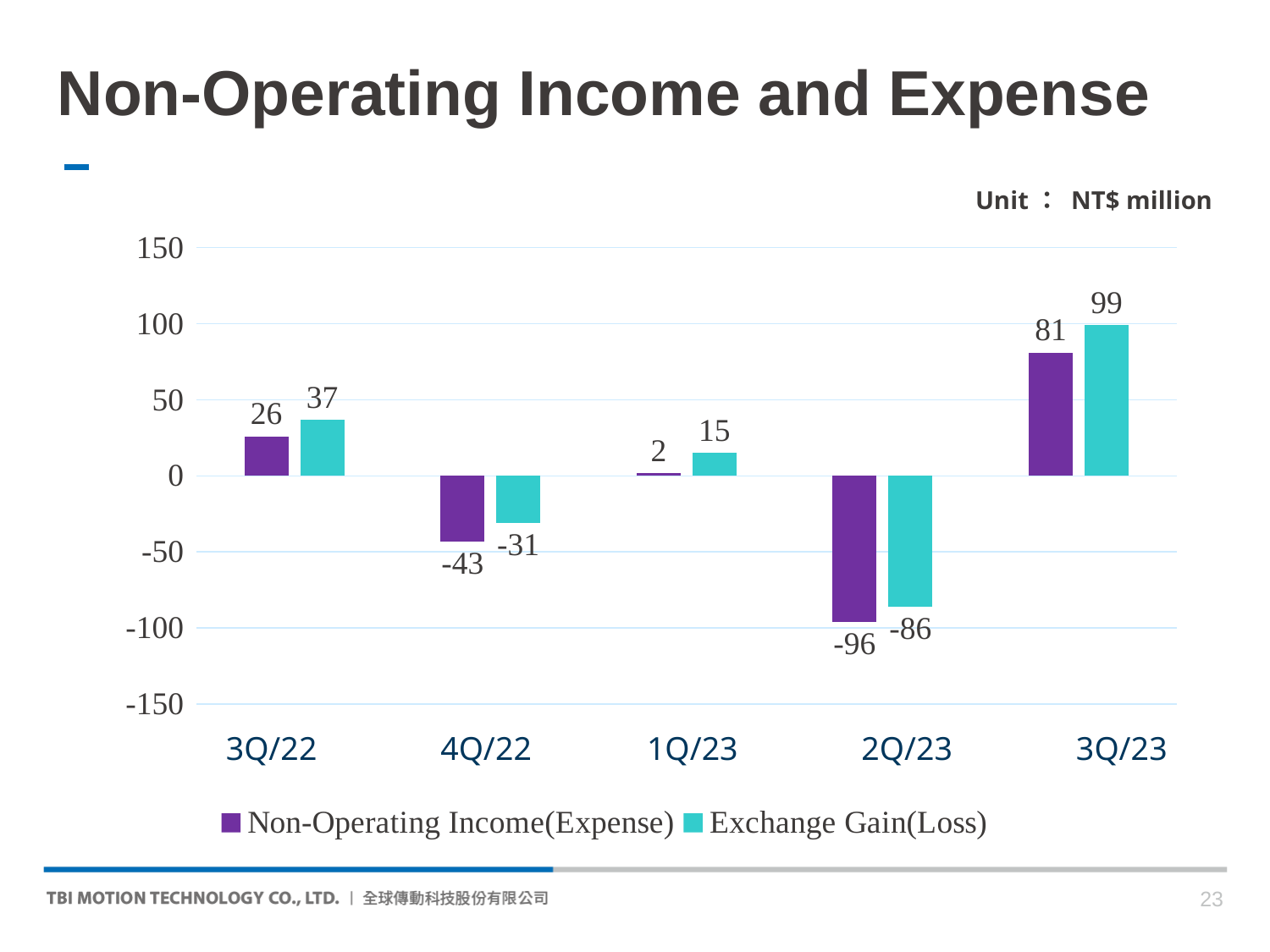
How many quarters are shown on the x axis? 5 Which is larger in 4Q/22: Non-Operating Income(Expense) or Exchange Gain(Loss)? Exchange Gain(Loss) Which colour represents Exchange Gain(Loss) in the legend? Teal What is the Non-Operating Income(Expense) value for 3Q/22? 26 What is the difference between the Exchange Gain(Loss) and Non-Operating Income(Expense) values in 3Q/23? 18 What is the Non-Operating Income(Expense) value for 1Q/23? 2 What kind of chart is shown on the slide? Bar chart What unit is stated for the chart values? NT$ million Which quarter has the highest Exchange Gain(Loss) value? 3Q/23 What is the Exchange Gain(Loss) value for 2Q/23? -86 How many series does the legend list? 2 Which quarter has the lowest Non-Operating Income(Expense) value? 2Q/23